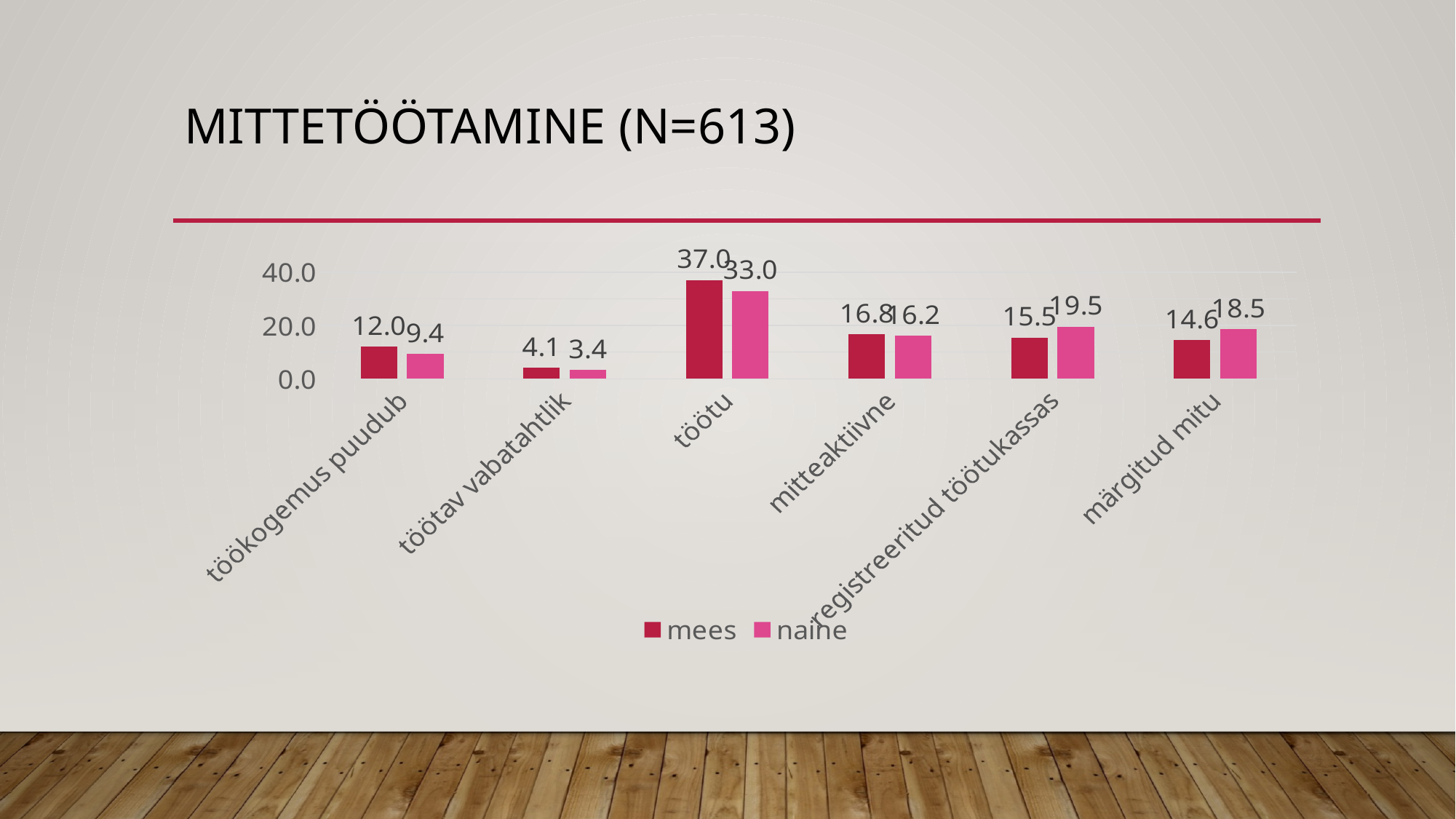
What is the difference between the mees and naine values in the töötu category? 4.0 What is the value for mees in the registreeritud töötukassas category? 15.5 What is the value for mees in the töötu category? 37.0 Which is larger in the märgitud mitu category, mees or naine? naine What is the title of the chart? MITTETÖÖTAMINE (N=613) How many series does the legend list? 2 Which category has the lowest value for naine? töötav vabatahtlik What kind of chart is shown on the slide? bar chart What is the value for naine in the töötav vabatahtlik category? 3.4 How many categories are shown on the x axis? 6 What is the value for naine in the märgitud mitu category? 18.5 Which category has the highest value for mees? töötu